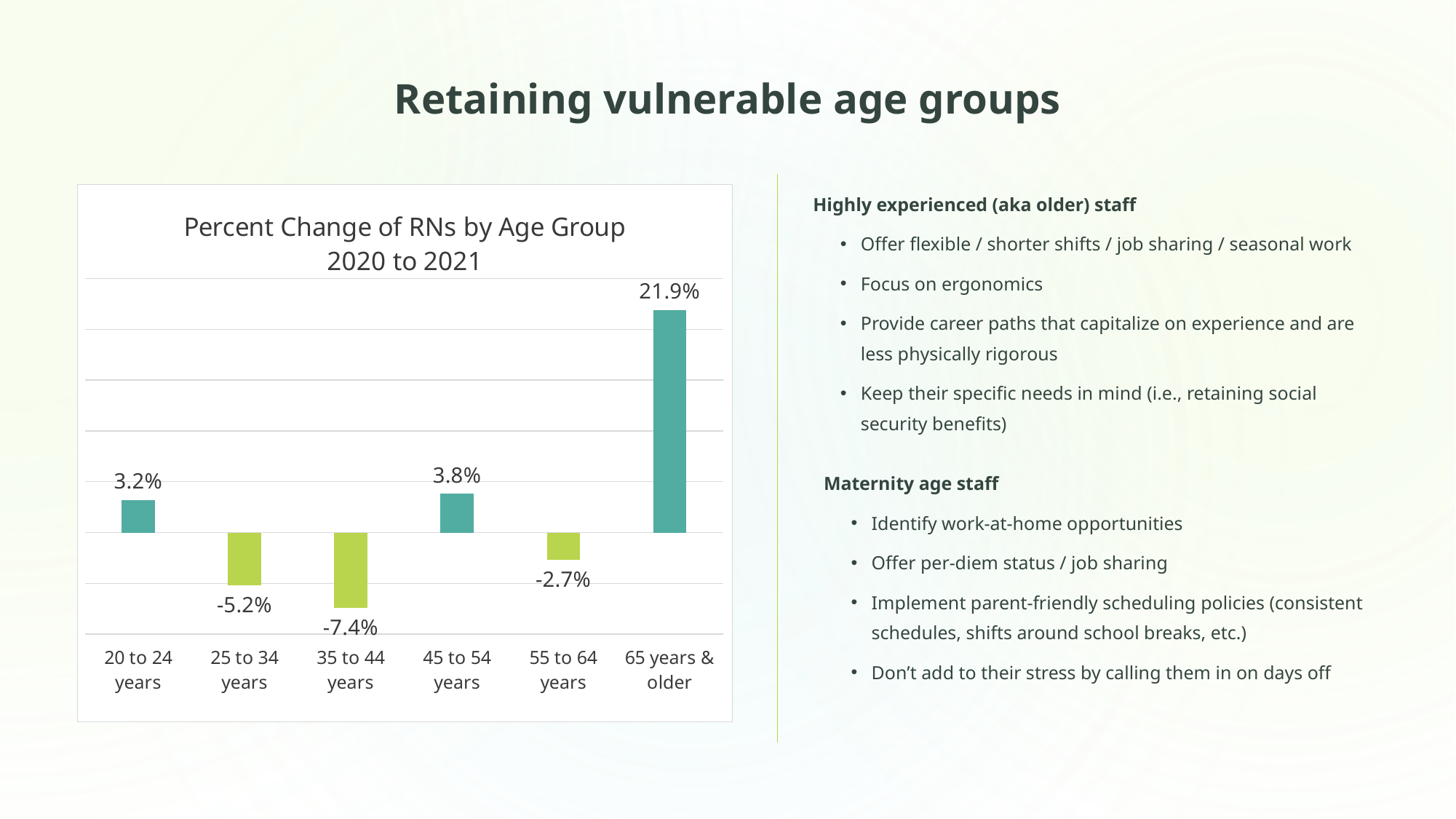
What is the percent change of RNs for the 20 to 24 years age group? 3.2% What is the title of the chart? Percent Change of RNs by Age Group 2020 to 2021 What is the percent change of RNs for the 55 to 64 years age group? -2.7% What is the percent change of RNs for the 35 to 44 years age group? -7.4% What is the percent change of RNs for the 65 years & older age group? 21.9% How many age groups are shown in the chart? 6 What is the difference between the percent change for 45 to 54 years and 20 to 24 years? 0.6% What type of chart is shown on the slide? Bar chart Which age group has a larger percent change, 25 to 34 years or 55 to 64 years? 55 to 64 years Which age group has the lowest percent change of RNs? 35 to 44 years Which age group has the highest percent change of RNs? 65 years & older How many age groups show a negative percent change? 3